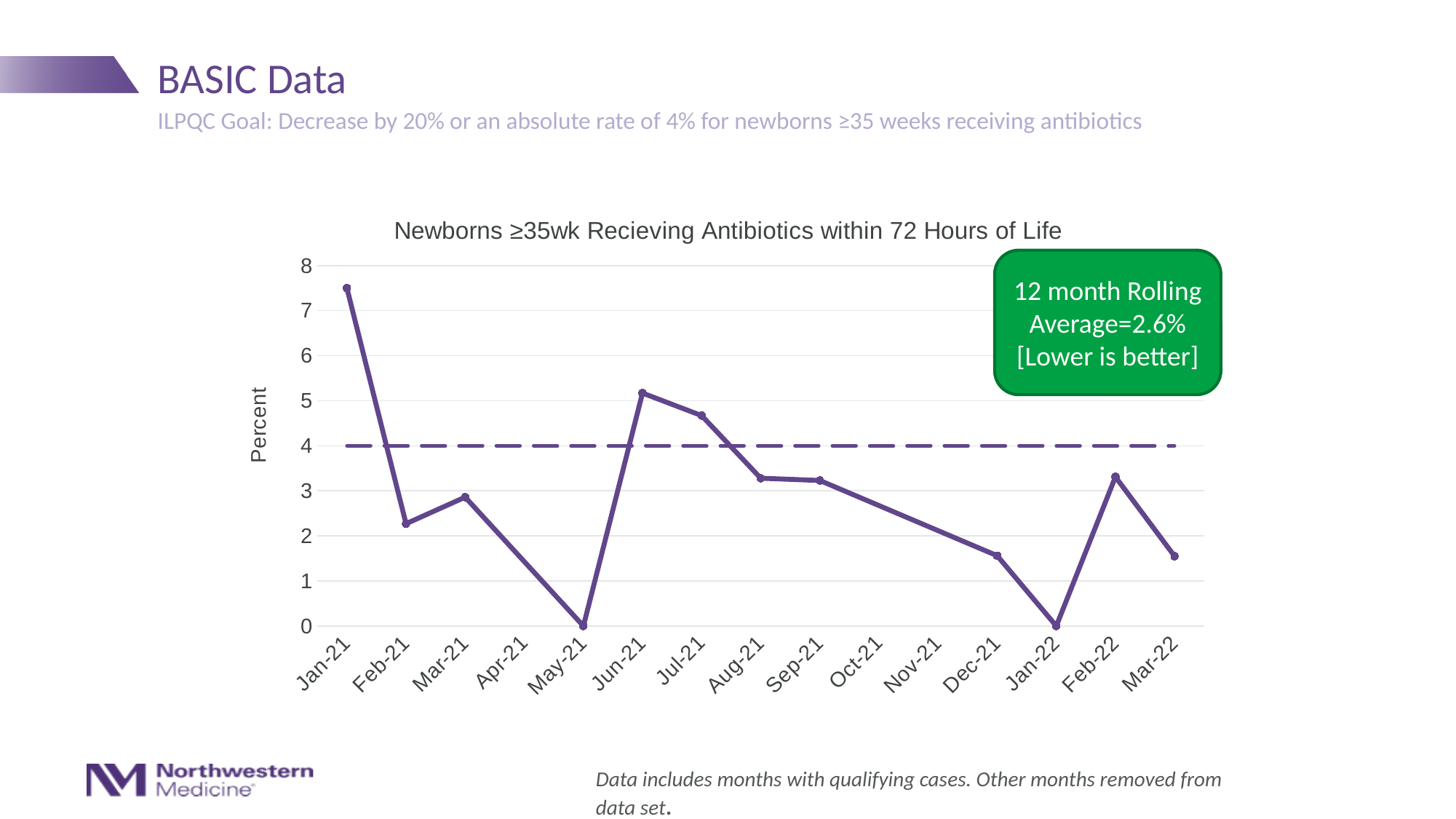
What is the title of the chart? Newborns ≥35wk Recieving Antibiotics within 72 Hours of Life What is the value for May-21? 0 Which month has the highest value? Jan-21 Is the value for Dec-21 greater or less than 2? less Which is larger, the value for Feb-21 or the value for Mar-21? Mar-21 Is the value for Feb-21 greater or less than 3? less Is the value for Jan-21 greater or less than 6? greater What is the value for Jan-22? 0 What is the 12 month rolling average stated in the callout on the chart? 2.6% What type of chart is shown on the slide? Line chart Do the values rise or fall from Jun-21 to Dec-21? Fall